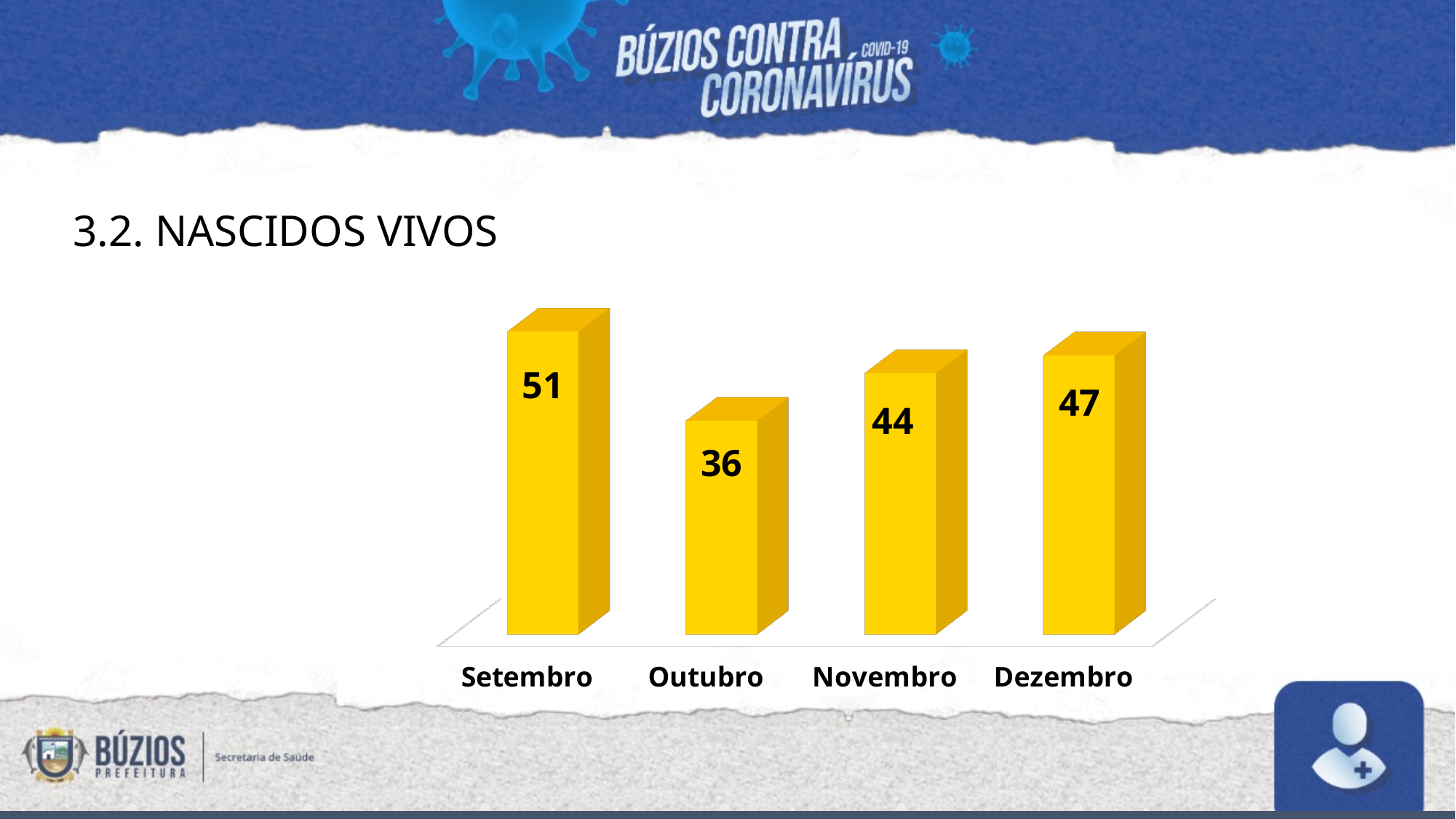
What is the difference between the values for Setembro and Outubro? 15 What is the value for Novembro? 44 What is the difference between the values for Dezembro and Novembro? 3 What is the value for Setembro? 51 Which is larger, the value for Novembro or the value for Dezembro? Dezembro What is the value for Outubro? 36 What is the value for Dezembro? 47 Which month has the lowest value? Outubro What kind of chart is shown on the slide? Bar chart How many months are shown in the chart? 4 Which month has the highest value? Setembro What is the title of the section containing the chart? 3.2. NASCIDOS VIVOS